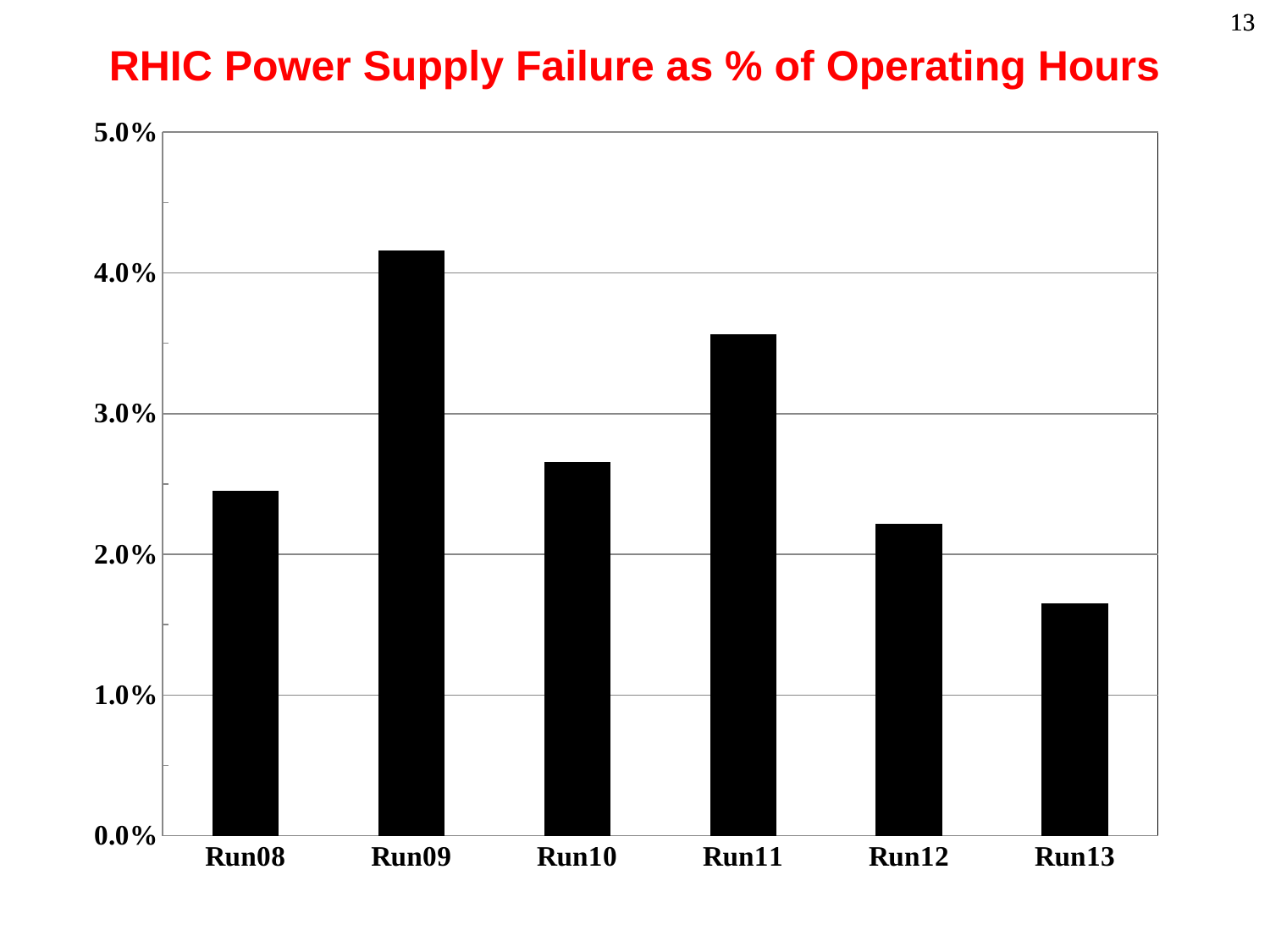
Is the value for Run12 greater or less than 3.0%? less Is the value for Run11 greater or less than 3.0%? greater Which run has the highest power supply failure percentage? Run09 What kind of chart is shown on the slide? bar chart How many runs are shown on the x axis? 6 What is the title of the chart? RHIC Power Supply Failure as % of Operating Hours Which is larger, the value for Run10 or the value for Run12? Run10 Do the values rise or fall from Run11 to Run13? fall Which is larger, the value for Run11 or the value for Run08? Run11 Which run has the lowest power supply failure percentage? Run13 Is the value for Run13 greater or less than 2.0%? less